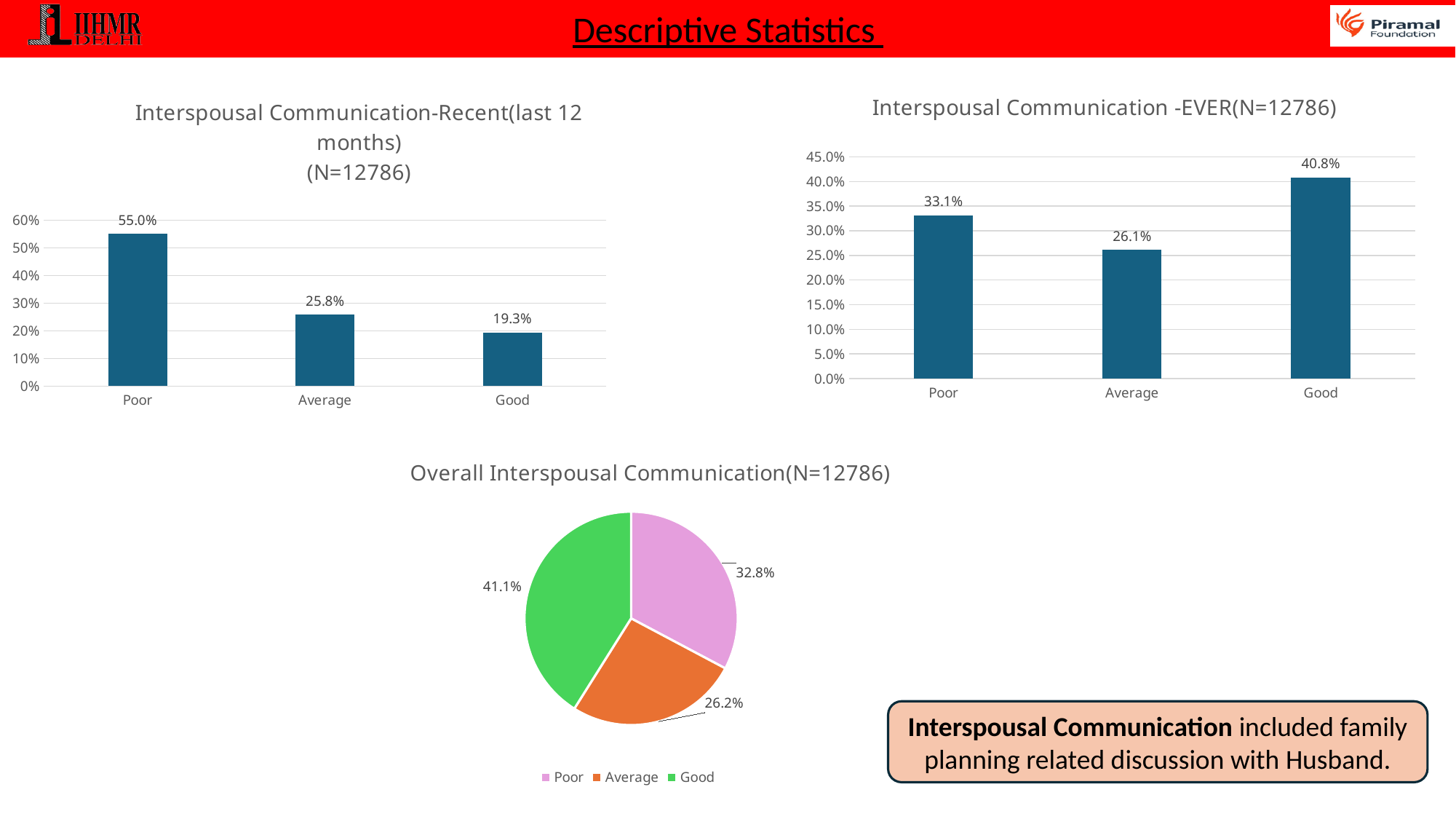
In the 'Interspousal Communication -EVER(N=12786)' chart, which is larger, the value for Poor or the value for Average? Poor In the 'Interspousal Communication -EVER(N=12786)' chart, which category has the highest value? Good In the 'Interspousal Communication -EVER(N=12786)' chart, is the value for Poor greater or less than 30.0%? greater What kind of chart is 'Overall Interspousal Communication(N=12786)'? Pie chart In the 'Interspousal Communication-Recent(last 12 months)' chart, which category has the lowest value? Good In the 'Overall Interspousal Communication(N=12786)' pie chart, what colour is the Poor slice? Pink In the 'Interspousal Communication-Recent(last 12 months)' chart, what is the value for Poor? 55.0% How many categories are shown in the 'Interspousal Communication -EVER(N=12786)' chart? 3 In the 'Interspousal Communication-Recent(last 12 months)' chart, what is the difference between the Poor and Average values? 29.2% In the 'Interspousal Communication -EVER(N=12786)' chart, what is the value for Good? 40.8% In the 'Overall Interspousal Communication(N=12786)' pie chart, what share does Good have? 41.1% In the 'Overall Interspousal Communication(N=12786)' pie chart, which slice is the smallest? Average